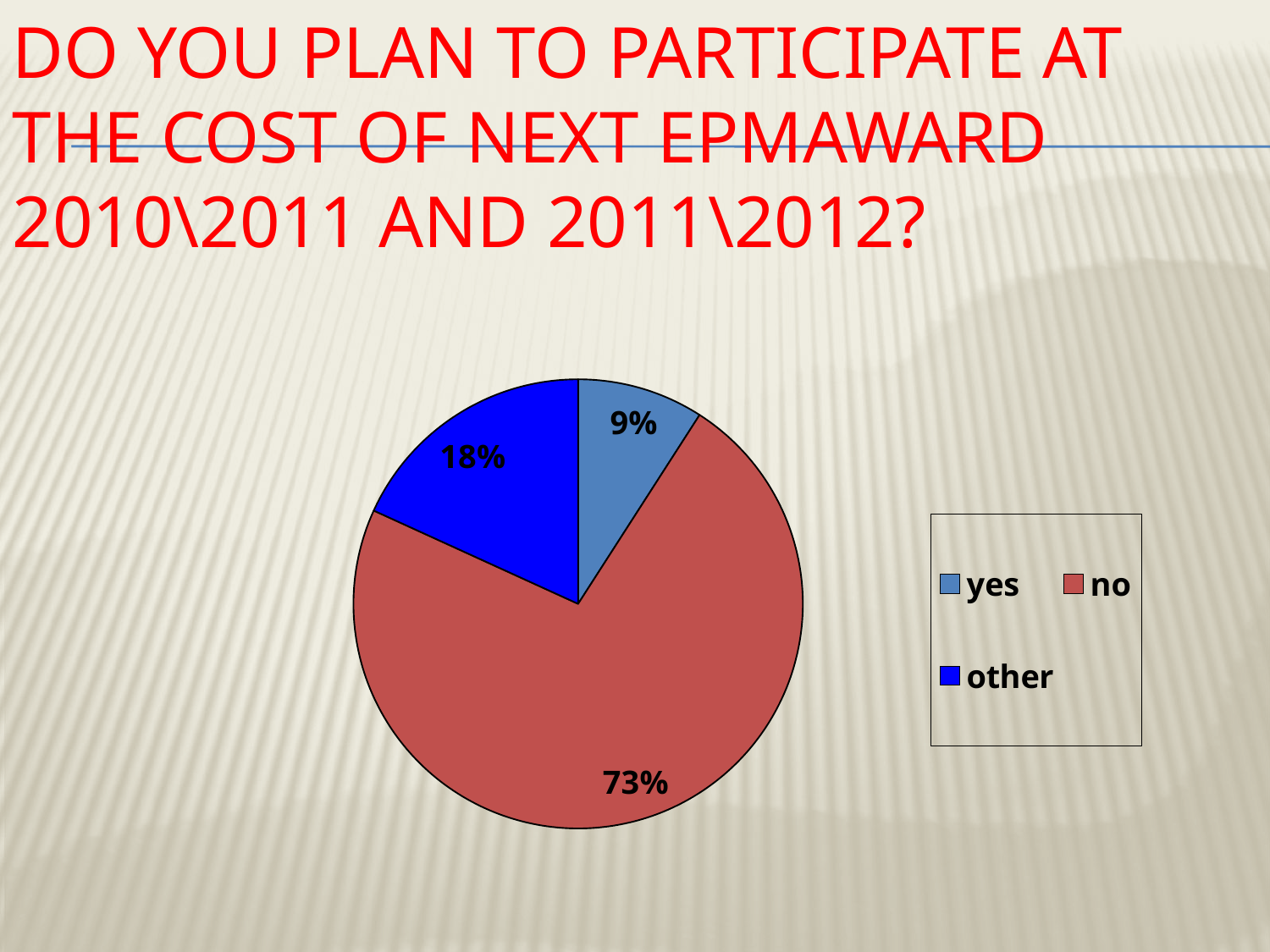
What share of the pie is labelled "no"? 73% What share of the pie is labelled "other"? 18% What colour is the "no" slice of the pie? red What share of the pie is labelled "yes"? 9% What is the difference in percentage points between the "no" slice and the "other" slice? 55 What is the difference in percentage points between the "other" slice and the "yes" slice? 9 What kind of chart is shown on the slide? pie chart Which category has the smallest slice of the pie? yes What colour is the "other" slice of the pie? blue How many categories does the legend list? 3 Which category has the largest slice of the pie? no Which slice is larger, "yes" or "other"? other